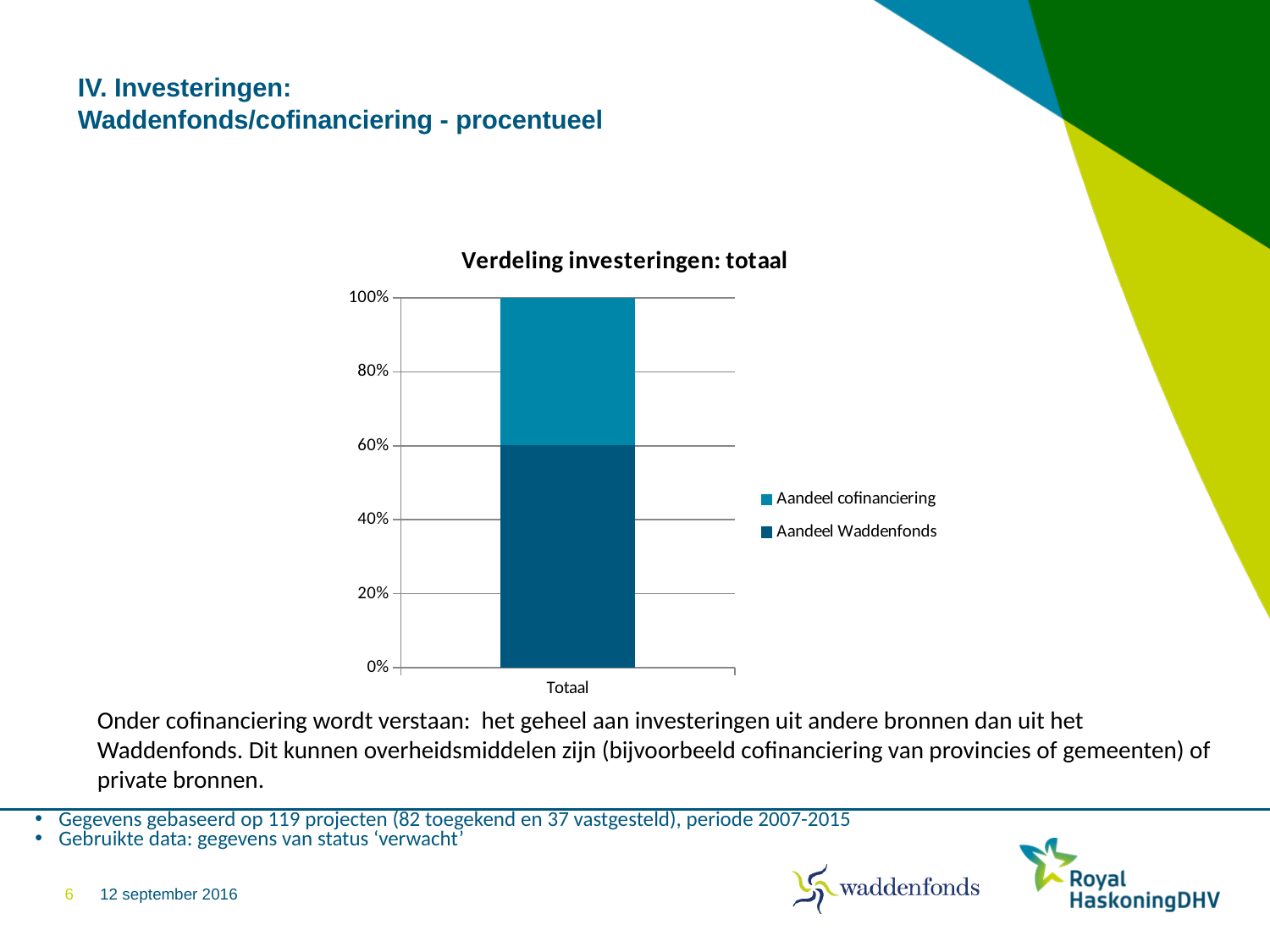
How many series does the legend list? 2 What is the label of the category on the x axis? Totaal Is the share for Aandeel cofinanciering greater or less than 20%? greater What is the total height of the stacked bar for Totaal? 100% Which series has the larger share of the Totaal bar, Aandeel Waddenfonds or Aandeel cofinanciering? Aandeel Waddenfonds Which series is shown at the bottom of the stacked bar? Aandeel Waddenfonds Is the share for Aandeel Waddenfonds greater or less than 40%? greater Is the share for Aandeel Waddenfonds greater or less than 80%? less How many categories are shown on the x axis? 1 What kind of chart is shown on the slide? bar chart What is the title of the chart? Verdeling investeringen: totaal